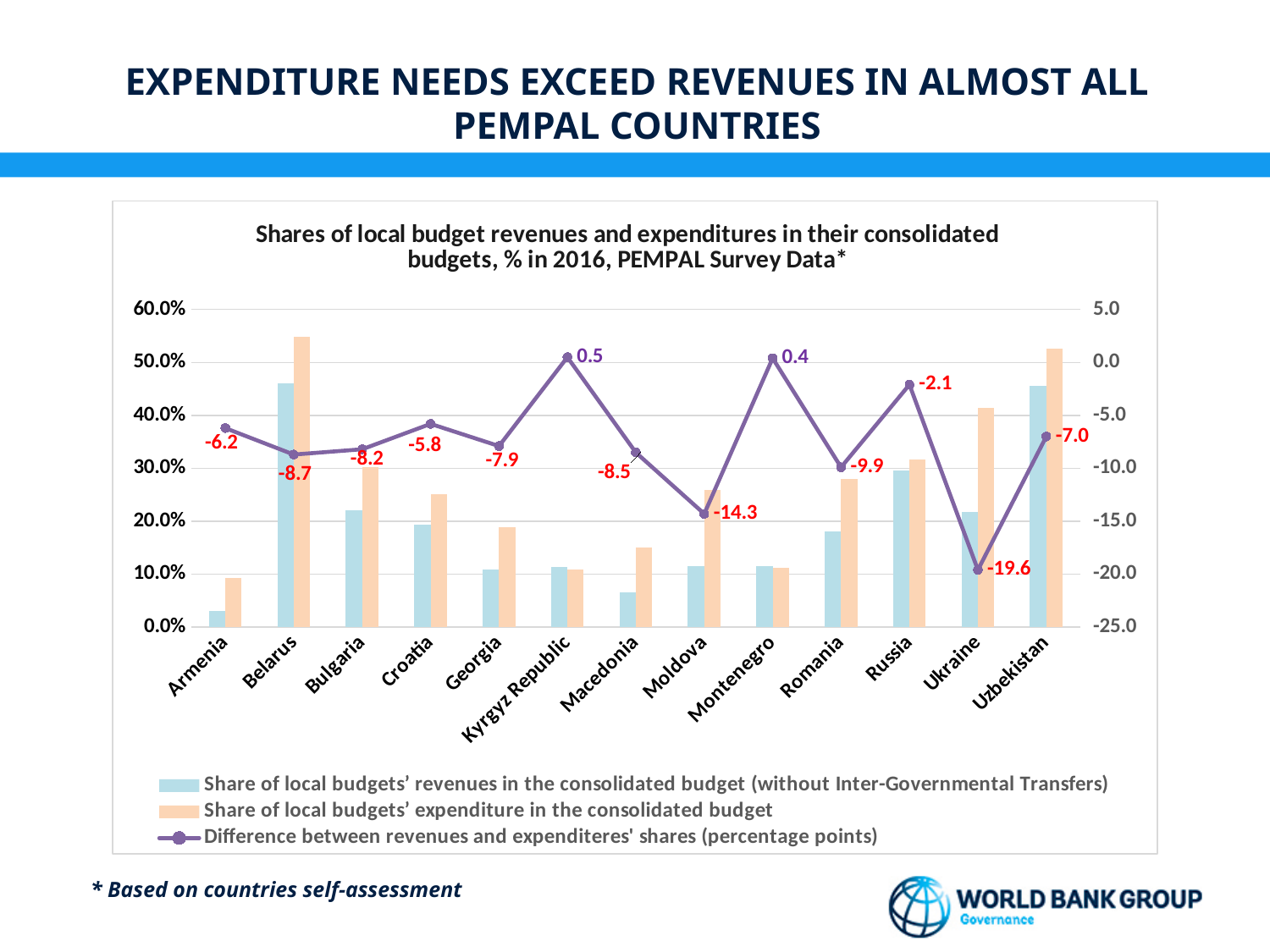
What is the difference between revenues and expenditures' shares (percentage points) for Ukraine? -19.6 What is the difference between revenues and expenditures' shares (percentage points) for Kyrgyz Republic? 0.5 How many series does the chart legend list? 3 How many countries are shown on the x axis of the chart? 13 Which country has the lowest value on the line for the difference between revenues and expenditures' shares? Ukraine What is the difference between revenues and expenditures' shares (percentage points) for Moldova? -14.3 By how many percentage points does the difference value for Moldova (-14.3) exceed that for Ukraine (-19.6)? 5.3 Is the share of local budgets' revenues in the consolidated budget for Armenia greater or less than 10.0%? less Which country has the highest value on the line for the difference between revenues and expenditures' shares? Kyrgyz Republic What kind of chart is shown on the slide? Combination bar and line chart Is the share of local budgets' expenditure in the consolidated budget for Belarus greater or less than 50.0%? greater